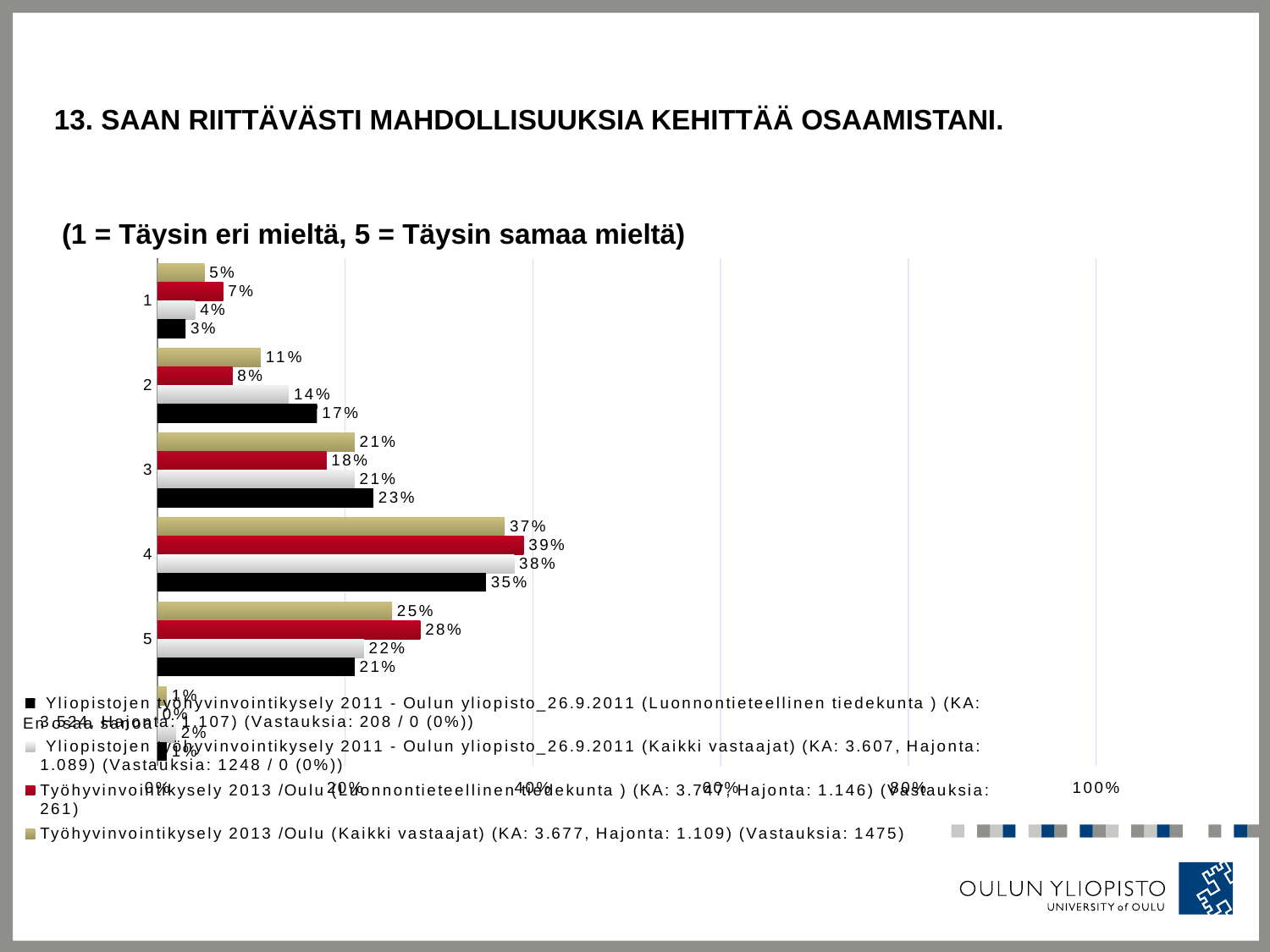
For category 4, what is the difference between the Työhyvinvointikysely 2013 /Oulu (Luonnontieteellinen tiedekunta) value and the Yliopistojen työhyvinvointikysely 2011 (Luonnontieteellinen tiedekunta) value? 4 percentage points What is the value for category 4 in the Työhyvinvointikysely 2013 /Oulu (Kaikki vastaajat) series? 37% What is the title of the slide containing the chart? 13. SAAN RIITTÄVÄSTI MAHDOLLISUUKSIA KEHITTÄÄ OSAAMISTANI. In the Työhyvinvointikysely 2013 /Oulu (Kaikki vastaajat) series, do the values rise or fall from category 1 to category 4? rise What is the value for category 5 in the Työhyvinvointikysely 2013 /Oulu (Luonnontieteellinen tiedekunta) series? 28% In the Työhyvinvointikysely 2013 /Oulu (Luonnontieteellinen tiedekunta) series, which category has the highest value? 4 What is the value for category 2 in the Yliopistojen työhyvinvointikysely 2011 (Luonnontieteellinen tiedekunta) series? 17% For category 2, which is larger: the Yliopistojen työhyvinvointikysely 2011 (Kaikki vastaajat) value or the Työhyvinvointikysely 2013 /Oulu (Kaikki vastaajat) value? Yliopistojen työhyvinvointikysely 2011 (Kaikki vastaajat) Is the value for category 4 in the Yliopistojen työhyvinvointikysely 2011 (Kaikki vastaajat) series greater or less than 20%? greater Among categories 1 to 5, which has the lowest value in the Yliopistojen työhyvinvointikysely 2011 (Kaikki vastaajat) series? 1 What kind of chart is shown on the slide? bar chart How many series does the chart legend list? 4